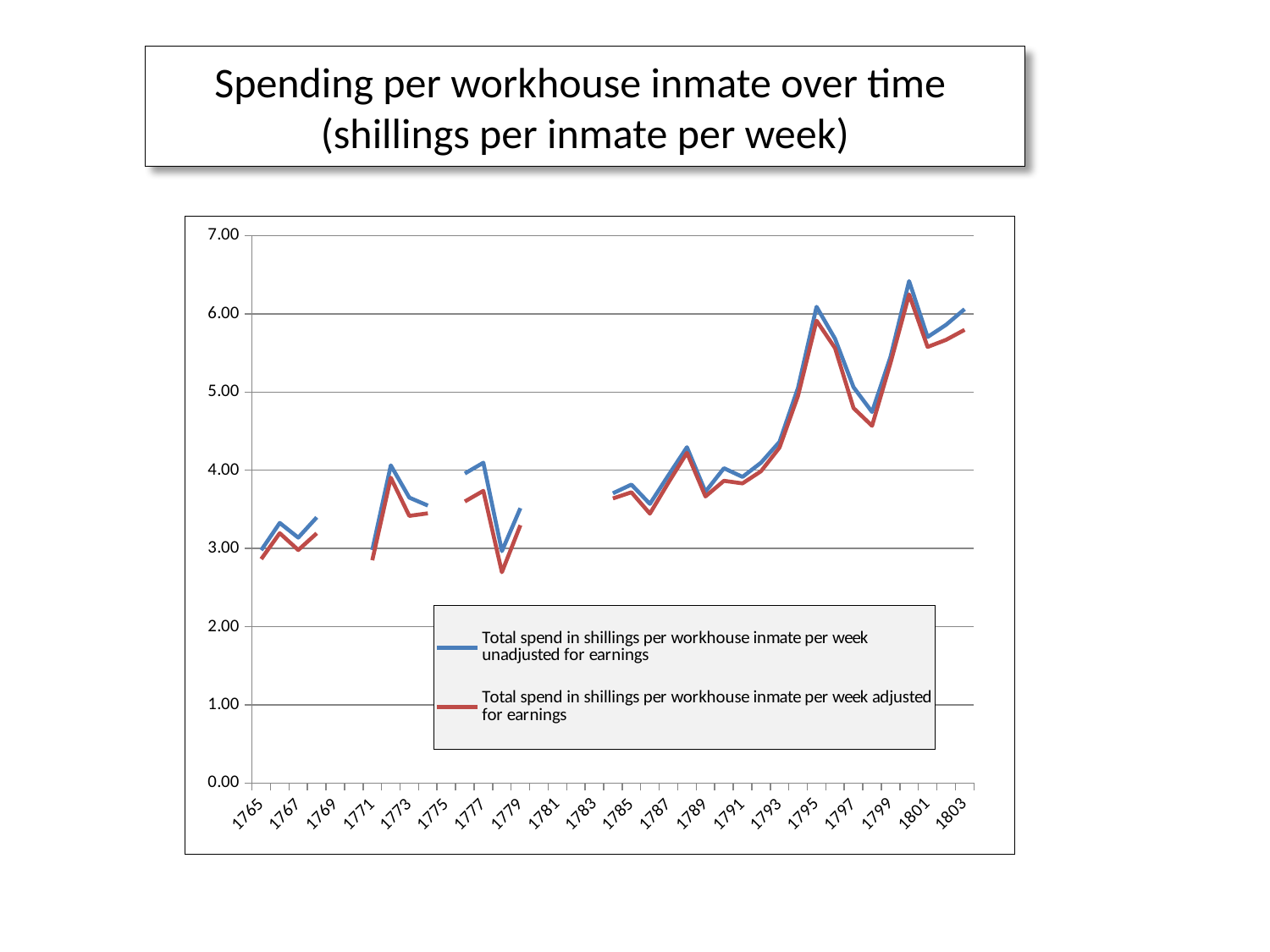
Is the value for the unadjusted series in 1800 greater or less than 6.00? greater Do the values generally rise or fall between 1790 and 1795? rise In which year does the unadjusted series reach its highest value? 1800 Is the value for the adjusted series in 1798 greater or less than 5.00? less Is the value for the unadjusted series in 1795 greater or less than 5.00? greater Which colour is used for the series adjusted for earnings? red How many series does the legend list? 2 What kind of chart is shown on the slide? line chart What is the title of the chart? Spending per workhouse inmate over time (shillings per inmate per week) In 1795, which series has the higher value, unadjusted for earnings or adjusted for earnings? unadjusted for earnings